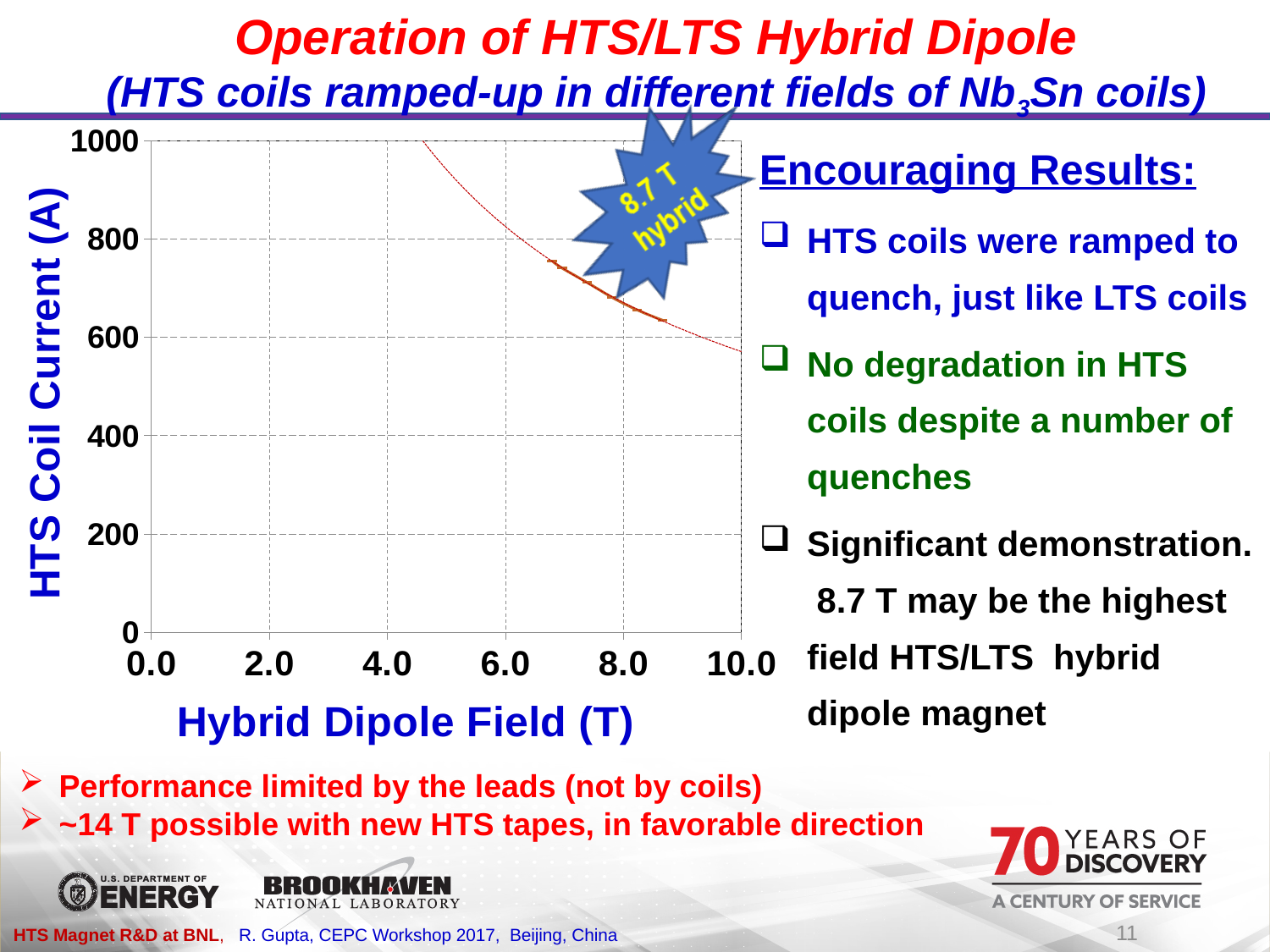
Is the HTS coil current at a hybrid dipole field of 7.0 T greater or less than 600 A? greater What is the label of the x axis of the chart? Hybrid Dipole Field (T) Is the HTS coil current at a hybrid dipole field of 6.0 T greater or less than 800 A? greater Does the HTS coil current rise or fall as the hybrid dipole field increases along the x axis? fall What is the label of the y axis of the chart? HTS Coil Current (A) Which has the higher HTS coil current on the curve: a hybrid dipole field of 7.0 T or 8.0 T? 7.0 T Is the HTS coil current at a hybrid dipole field of 8.0 T greater or less than 800 A? less What kind of chart is shown on the slide? line chart What is the highest value shown on the y axis of the chart? 1000